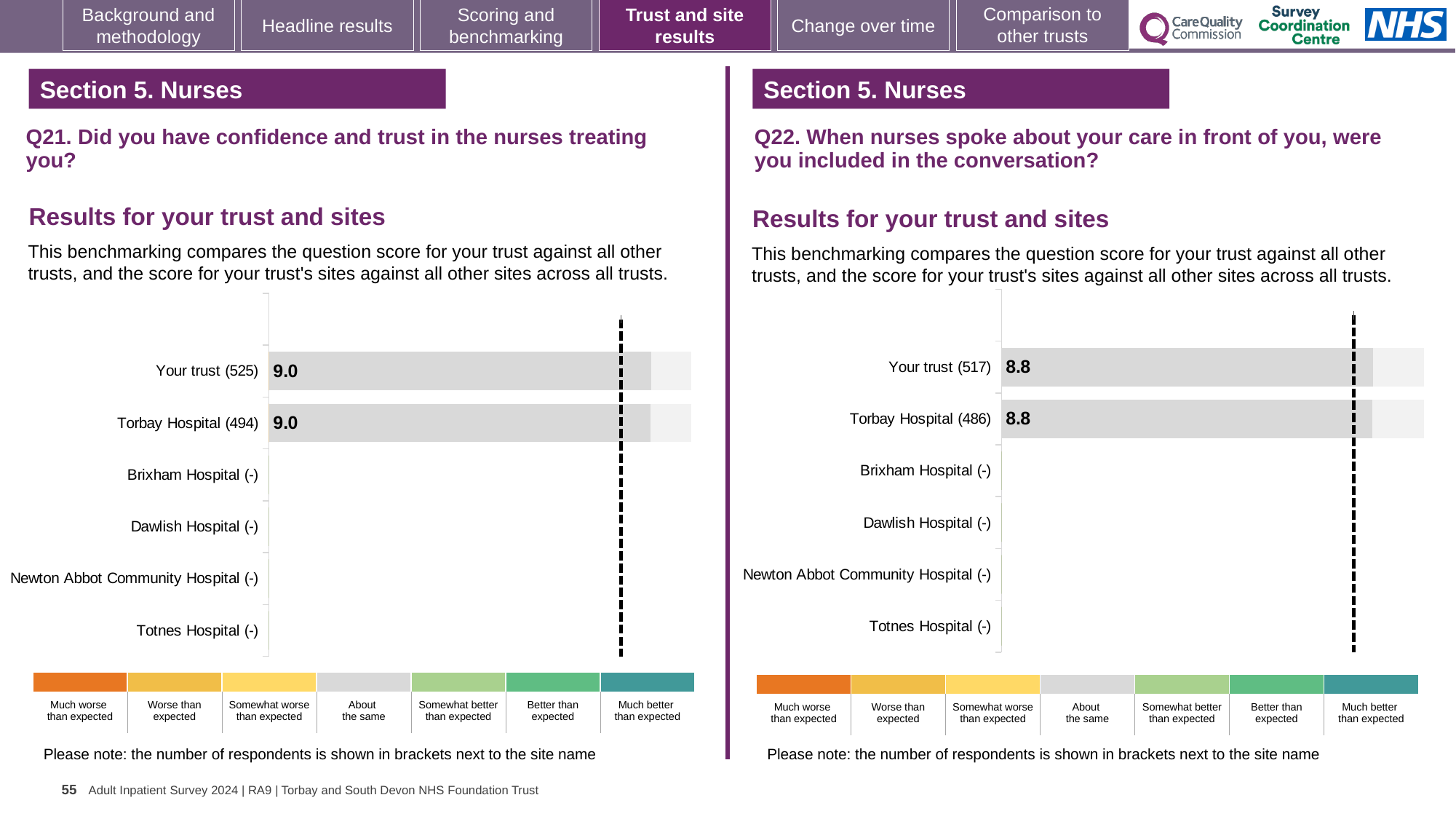
In the Q22 chart on the right, which site is listed last on the y axis? Totnes Hospital (-) How many site/trust categories are listed on the y axis of the Q22 chart on the right? 6 In the Q21 chart on the left, what is the score for Torbay Hospital (494)? 9.0 In the Q22 chart on the right, what is the difference between the scores for Your trust and Torbay Hospital? 0.0 In the Q21 chart on the left, how many respondents are shown in brackets for Torbay Hospital? 494 In the Q22 chart on the right, how many respondents are shown in brackets for Your trust? 517 In the Q21 chart on the left, what is the difference between the scores for Your trust and Torbay Hospital? 0.0 What kind of chart is used for the Q21 results on the left? Bar chart In the Q22 chart on the right, what is the score for Torbay Hospital (486)? 8.8 How many site/trust categories are listed on the y axis of the Q21 chart on the left? 6 In the Q22 chart on the right, what is the score for Your trust (517)? 8.8 In the Q21 chart on the left, what is the score for Your trust (525)? 9.0